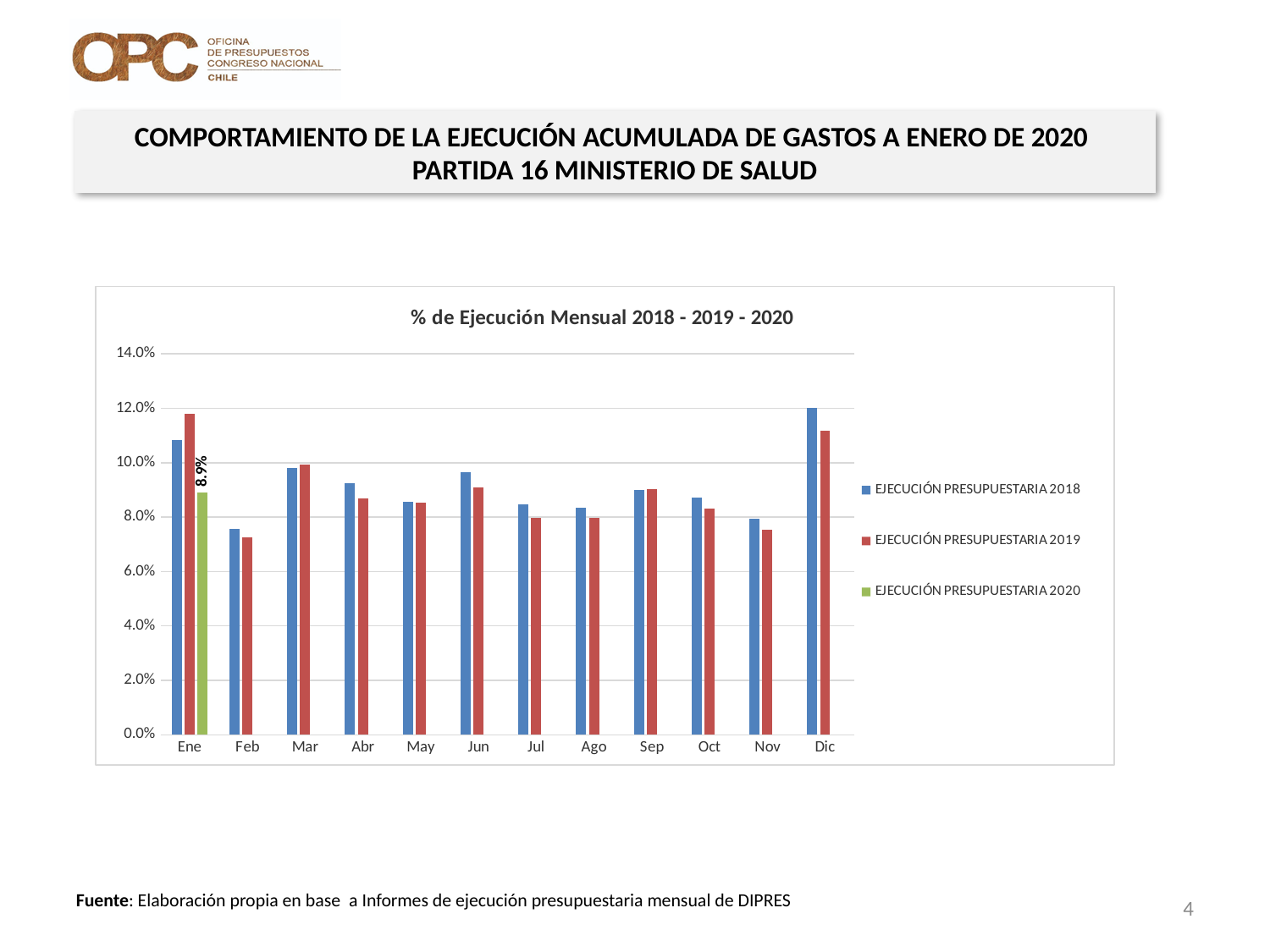
Is the value for EJECUCIÓN PRESUPUESTARIA 2018 in Feb greater or less than 8.0%? less Which month has the highest value for EJECUCIÓN PRESUPUESTARIA 2019? Ene What is the title of the chart? % de Ejecución Mensual 2018 - 2019 - 2020 What kind of chart is shown on the slide? Bar chart What is the value for EJECUCIÓN PRESUPUESTARIA 2020 in Ene? 8.9% In Dic, which is larger: EJECUCIÓN PRESUPUESTARIA 2018 or EJECUCIÓN PRESUPUESTARIA 2019? EJECUCIÓN PRESUPUESTARIA 2018 Is the value for EJECUCIÓN PRESUPUESTARIA 2018 in Dic greater or less than 10.0%? greater What colour represents EJECUCIÓN PRESUPUESTARIA 2020 in the chart? Green How many months are shown on the x axis of the chart? 12 In Ene, which is larger: EJECUCIÓN PRESUPUESTARIA 2018 or EJECUCIÓN PRESUPUESTARIA 2019? EJECUCIÓN PRESUPUESTARIA 2019 How many series does the legend list? 3 Which month has the highest value for EJECUCIÓN PRESUPUESTARIA 2018? Dic